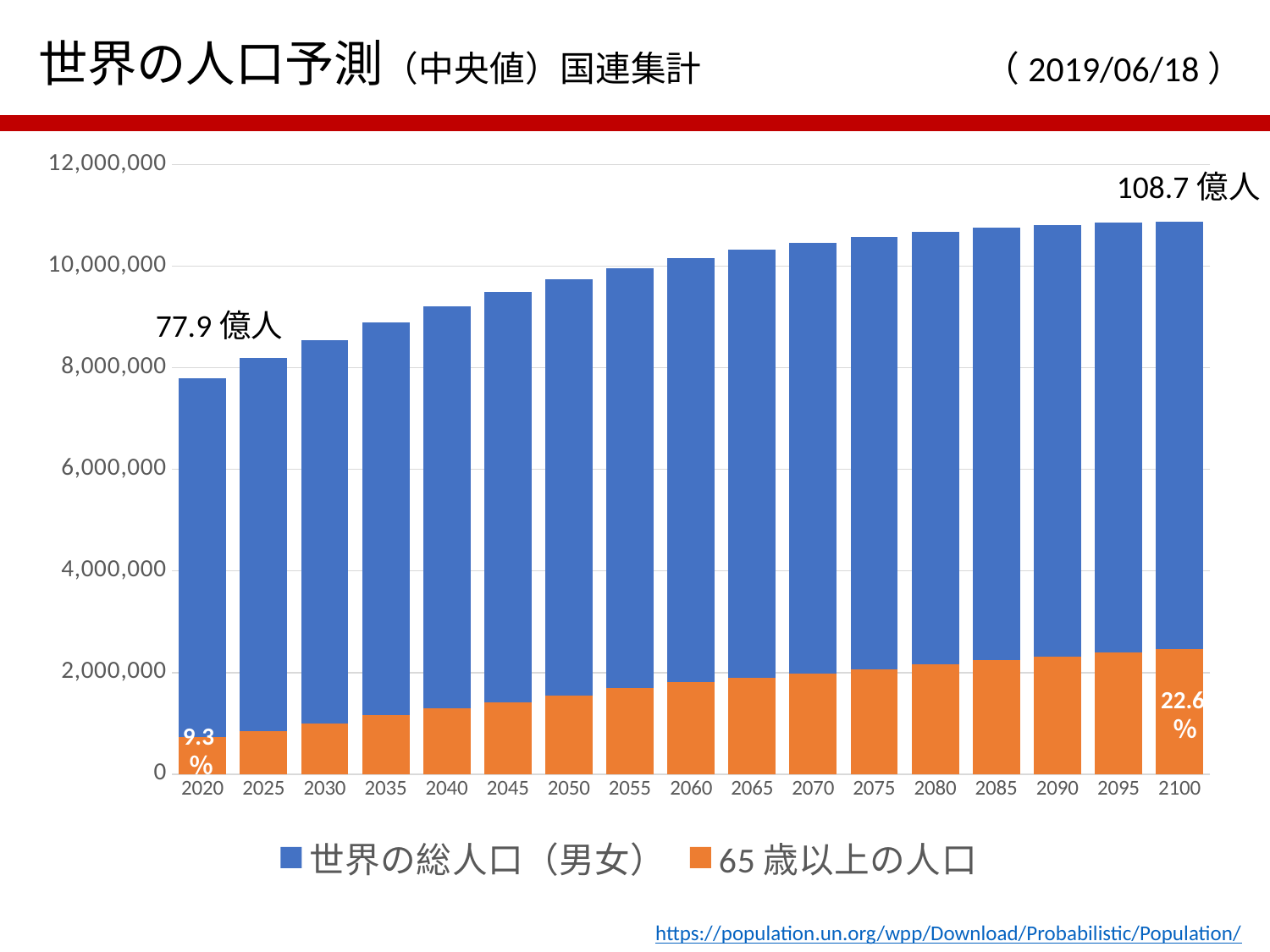
What is the labelled world total population for 2020? 77.9 億人 What kind of chart is shown on the slide? bar chart What is the difference between the labelled total population for 2100 and for 2020? 30.8 億人 What percentage is labelled on the 65歳以上の人口 bar for 2100? 22.6% What is the labelled world total population for 2100? 108.7 億人 What percentage is labelled on the 65歳以上の人口 bar for 2020? 9.3% Which year has the highest world total population in the chart? 2100 Is the world total population for 2060 greater or less than 10,000,000? greater Which colour represents 65歳以上の人口 in the chart? orange Does the world total population rise or fall from 2020 to 2100? rise How many years are shown along the x axis of the chart? 17 How many series does the legend list? 2